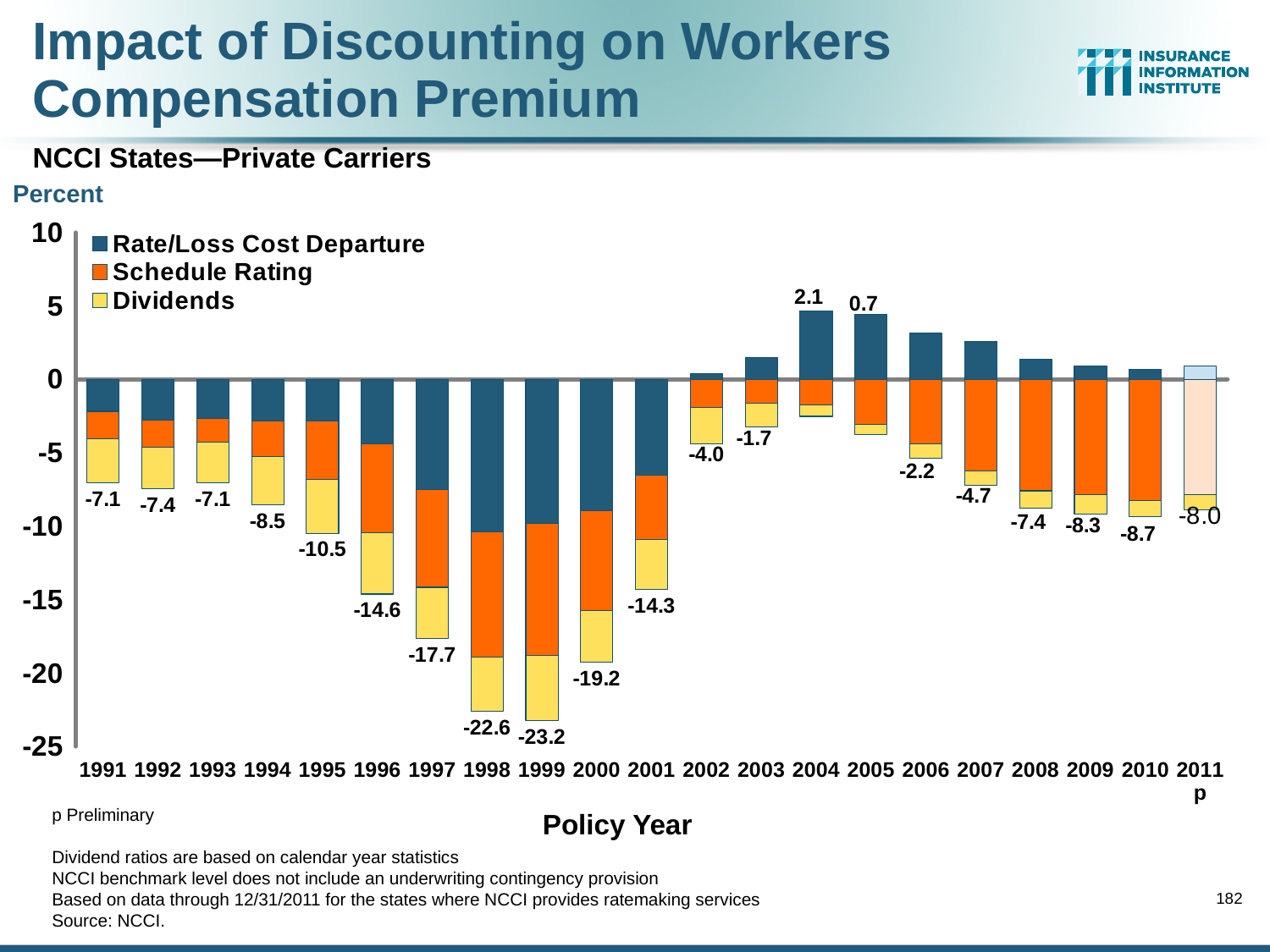
What is the total labeled value for policy year 2004? 2.1 What is the difference between the labeled totals for 1998 and 1999? 0.6 Is the labeled total for 1996 greater or less than -10? less Which policy year has the lowest labeled total? 1999 What is the total labeled value for policy year 2011p? -8.0 What is the total labeled value for policy year 1999? -23.2 Which policy year has a larger labeled total, 2004 or 2005? 2004 Which policy year has the highest labeled total? 2004 How many policy years are shown on the x axis? 21 What kind of chart is shown on the slide? Stacked bar chart Do the labeled totals rise or fall from 1995 to 1999? fall How many series does the legend list? 3